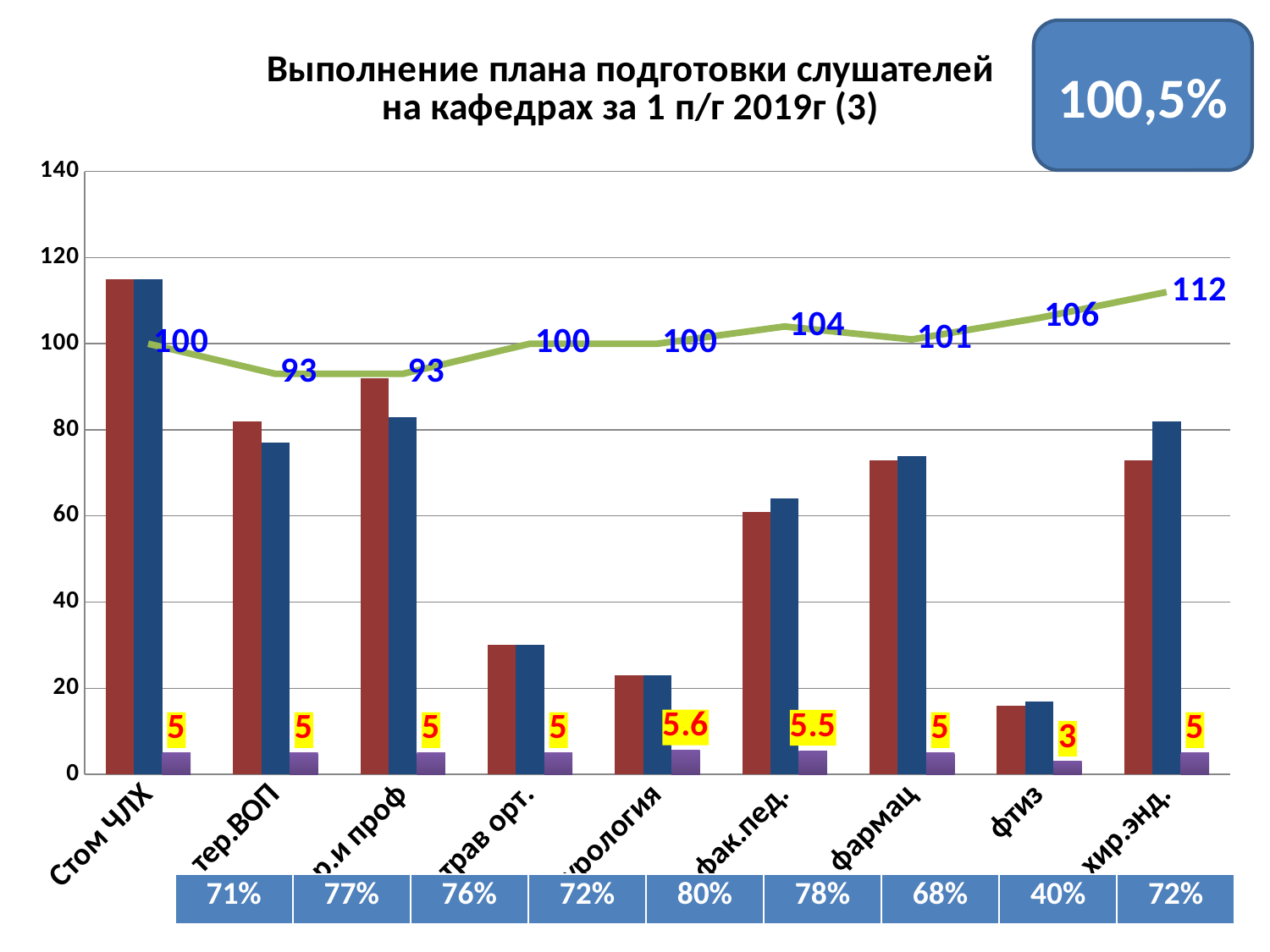
What is the labelled value of the purple bar for фтиз? 3 Which category has the highest value on the line? хир.энд. Which category has the lowest labelled purple bar? фтиз Which has a higher line value, фтиз or фармац? фтиз How many categories are shown on the x axis? 9 Is the value of the blue bar for фтиз greater or less than 20? less What is the value of the line for хир.энд.? 112 Does the line rise or fall from фармац to хир.энд.? rises What is the labelled value of the purple bar for фак.пед.? 5.5 What is the difference between the line values for хир.энд. and Стом ЧЛХ? 12 What is the value of the line for фак.пед.? 104 Is the value of the red bar for Стом ЧЛХ greater or less than 100? greater